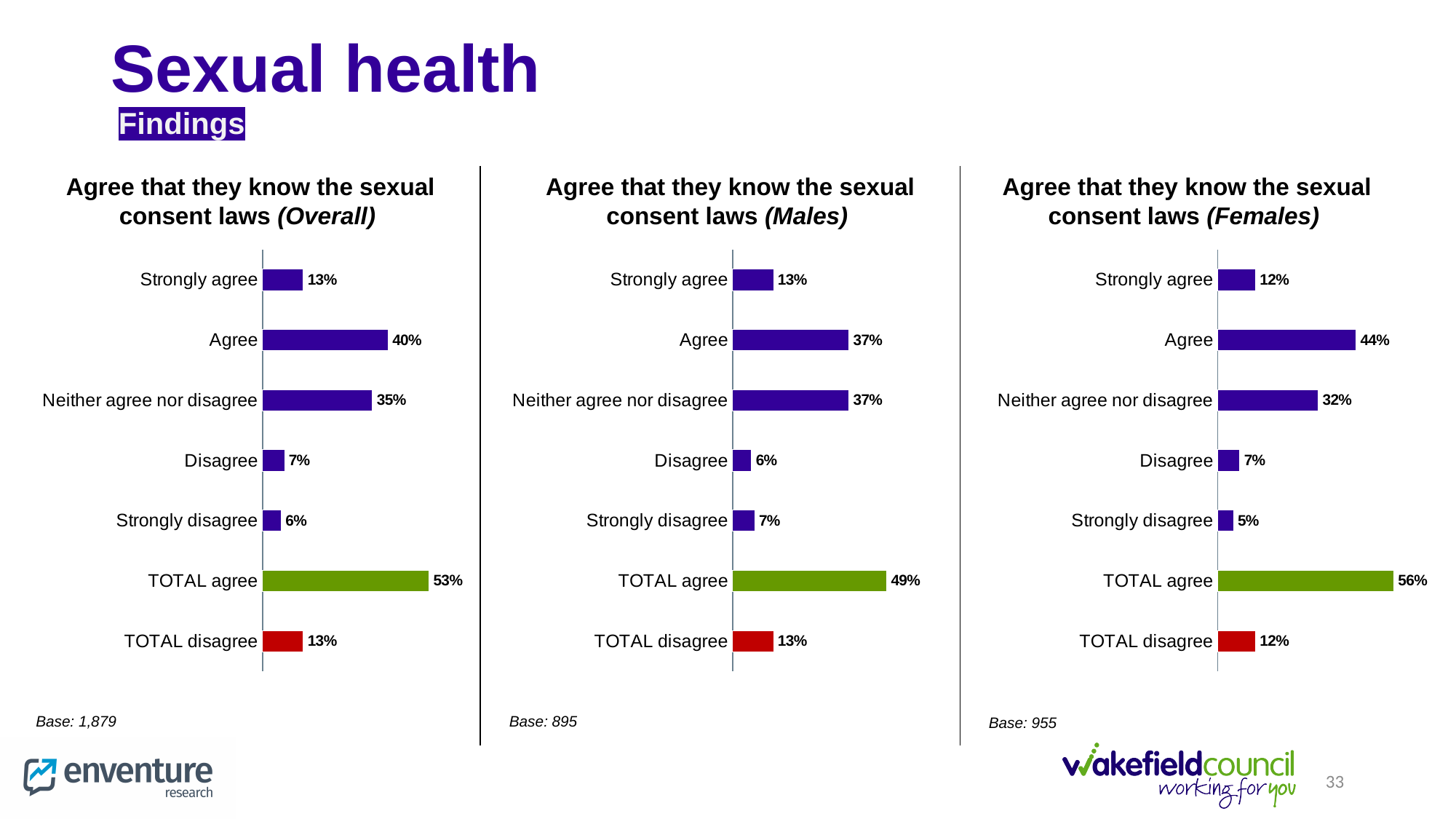
In the Males chart, what is the value for TOTAL agree? 49% In the Females chart, what colour is the TOTAL disagree bar? Red In the Overall chart, which category has the lowest value? Strongly disagree In the Overall chart, what is the value for Agree? 40% What kind of chart is the Overall chart? Bar chart In the Females chart, which category has the highest value? TOTAL agree How many categories are shown in the Males chart? 7 Which is larger in the Males chart: Disagree or Strongly disagree? Strongly disagree Which is larger in the Overall chart: Agree or Neither agree nor disagree? Agree In the Males chart, what is the difference between TOTAL agree and TOTAL disagree? 36% In the Females chart, what is the difference between Agree and Strongly agree? 32% In the Females chart, what is the value for Neither agree nor disagree? 32%